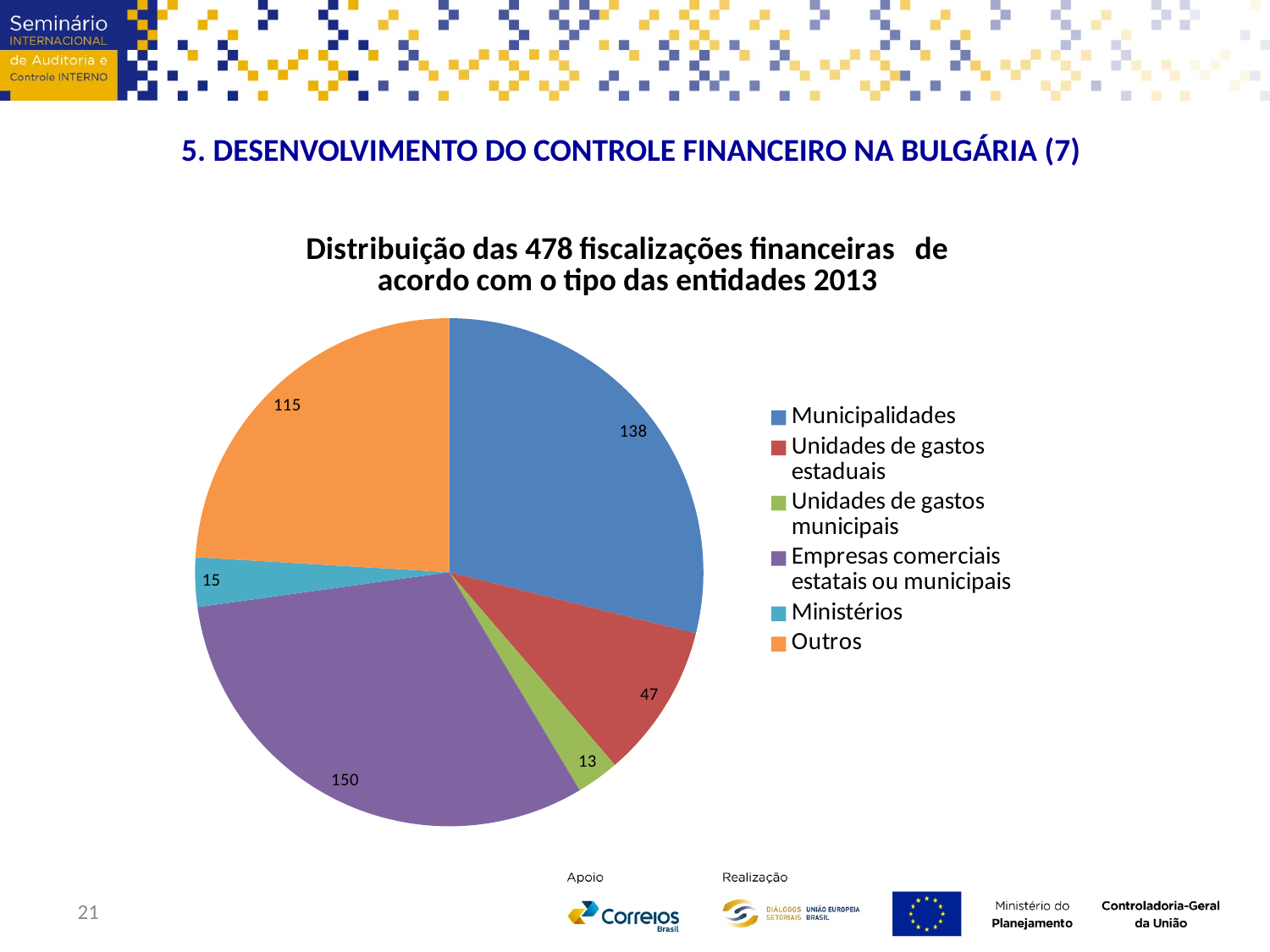
How many slices does the pie chart have? 6 What is the value for Empresas comerciais estatais ou municipais? 150 Which category has the largest slice? Empresas comerciais estatais ou municipais What type of chart is shown on the slide? pie chart Which category has the smallest slice? Unidades de gastos municipais What is the value for Unidades de gastos municipais? 13 What is the title of the chart? Distribuição das 478 fiscalizações financeiras de acordo com o tipo das entidades 2013 What is the difference between the values for Empresas comerciais estatais ou municipais and Municipalidades? 12 What is the value for Ministérios? 15 What is the value for Municipalidades? 138 How many entries does the legend list? 6 Which is larger, the value for Outros or the value for Unidades de gastos estaduais? Outros